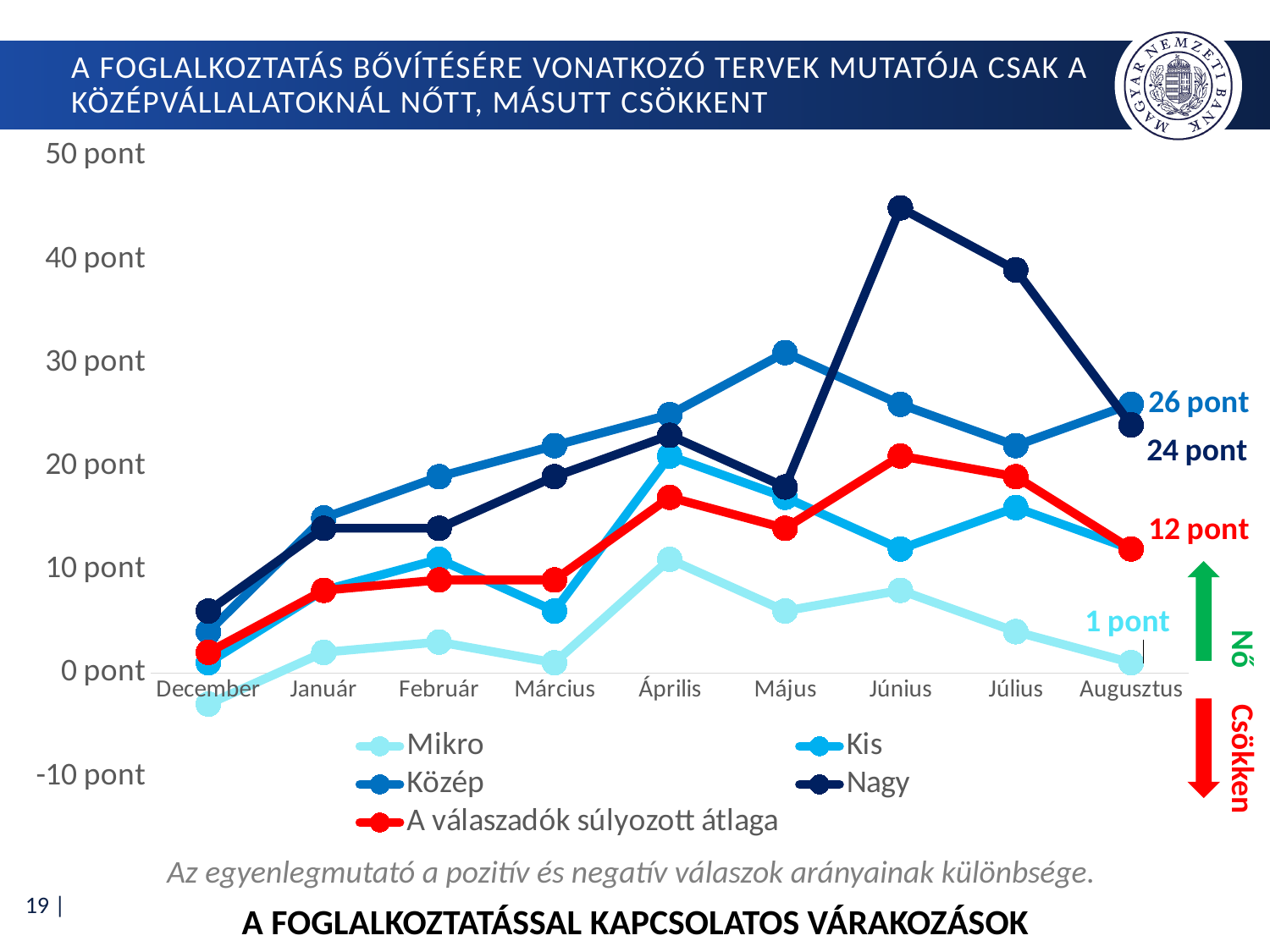
How many months are shown along the x axis? 9 Which is larger in Augusztus, the Közép value or the Nagy value? Közép Is the value for Nagy in Június greater or less than 40 pont? greater Does the Nagy series rise or fall from Június to Augusztus? fall What is the value of 'A válaszadók súlyozott átlaga' in Augusztus? 12 pont What is the value of the Mikro series in Augusztus? 1 pont What is the value of the Közép series in Augusztus? 26 pont What is the difference between the Közép and Nagy values in Augusztus? 2 pont Which series has the highest value in Június? Nagy What is the value of the Nagy series in Augusztus? 24 pont What kind of chart is shown on the slide? line chart How many series does the legend list? 5